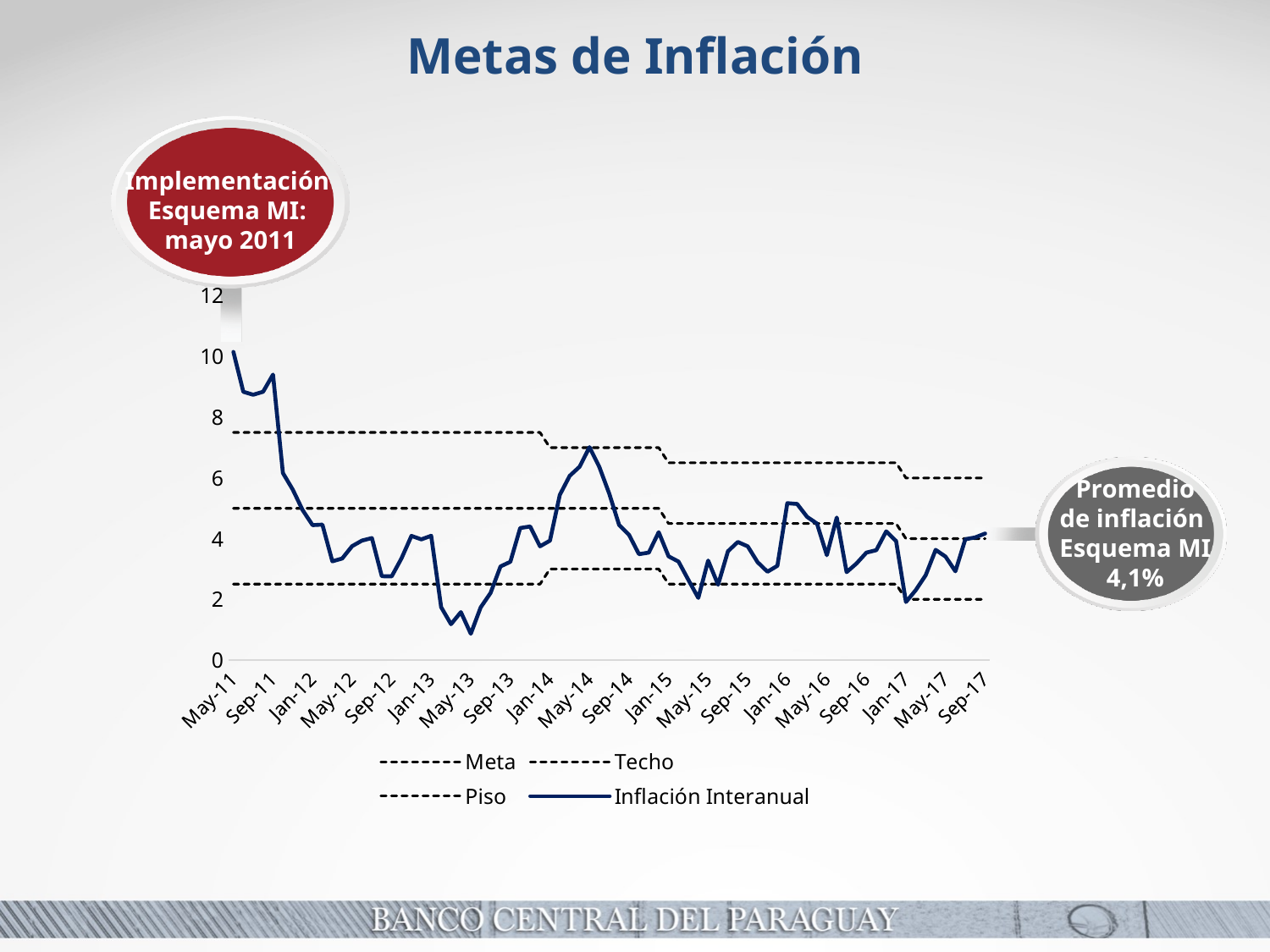
According to the callout on the chart, what is the average inflation under the Esquema MI? 4,1% What kind of chart is shown on the slide? line chart At Jan-16, which is higher, Meta or Inflación Interanual? Inflación Interanual Does the Meta line rise or fall over the period shown? fall At which x-axis date does Inflación Interanual reach its highest value? May-11 Is the value of Techo at Jan-12 greater or less than 6? greater Is the value of Inflación Interanual at May-11 greater or less than 8? greater Is the value of Piso at Jan-12 greater or less than 4? less What are the series names listed in the legend? Meta, Techo, Piso, Inflación Interanual Overall, from May-11 to Sep-17, does the Inflación Interanual line rise or fall? fall How many series does the legend list? 4